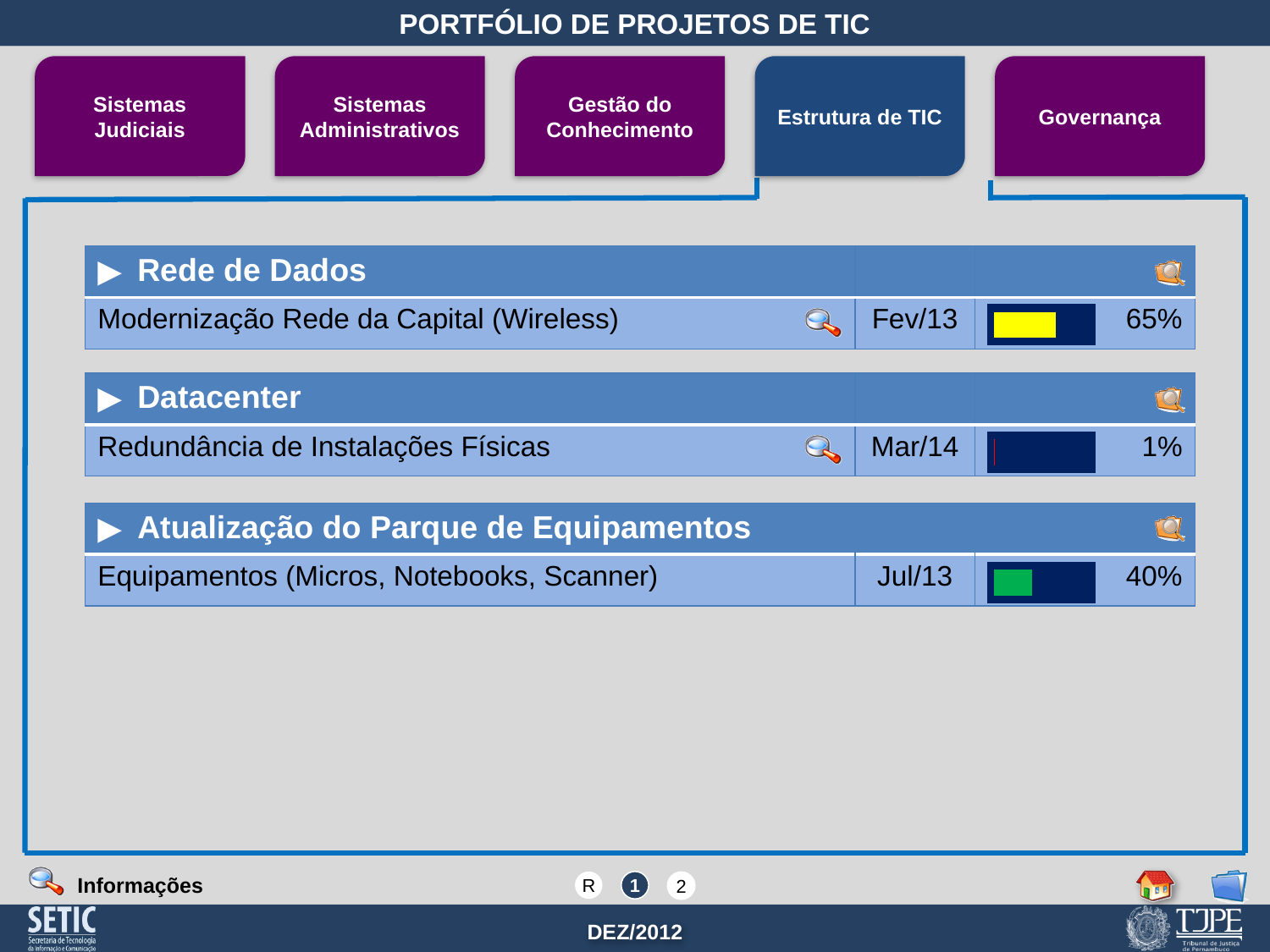
What colour is the filled portion of the progress bar for 'Modernização Rede da Capital (Wireless)'? Yellow How many projects with progress bars are listed on the slide? 3 What date is shown next to the project 'Redundância de Instalações Físicas'? Mar/14 Which project has the highest completion percentage? Modernização Rede da Capital (Wireless) What completion percentage is shown for the project 'Modernização Rede da Capital (Wireless)'? 65% What completion percentage is shown for 'Redundância de Instalações Físicas'? 1% Which has a higher completion percentage: 'Equipamentos (Micros, Notebooks, Scanner)' or 'Redundância de Instalações Físicas'? Equipamentos (Micros, Notebooks, Scanner) What completion percentage is shown for 'Equipamentos (Micros, Notebooks, Scanner)'? 40% What colour is the filled portion of the progress bar for 'Equipamentos (Micros, Notebooks, Scanner)'? Green Which project has the lowest completion percentage? Redundância de Instalações Físicas What is the difference in completion percentage between 'Modernização Rede da Capital (Wireless)' and 'Equipamentos (Micros, Notebooks, Scanner)'? 25% What date is shown next to 'Modernização Rede da Capital (Wireless)'? Fev/13